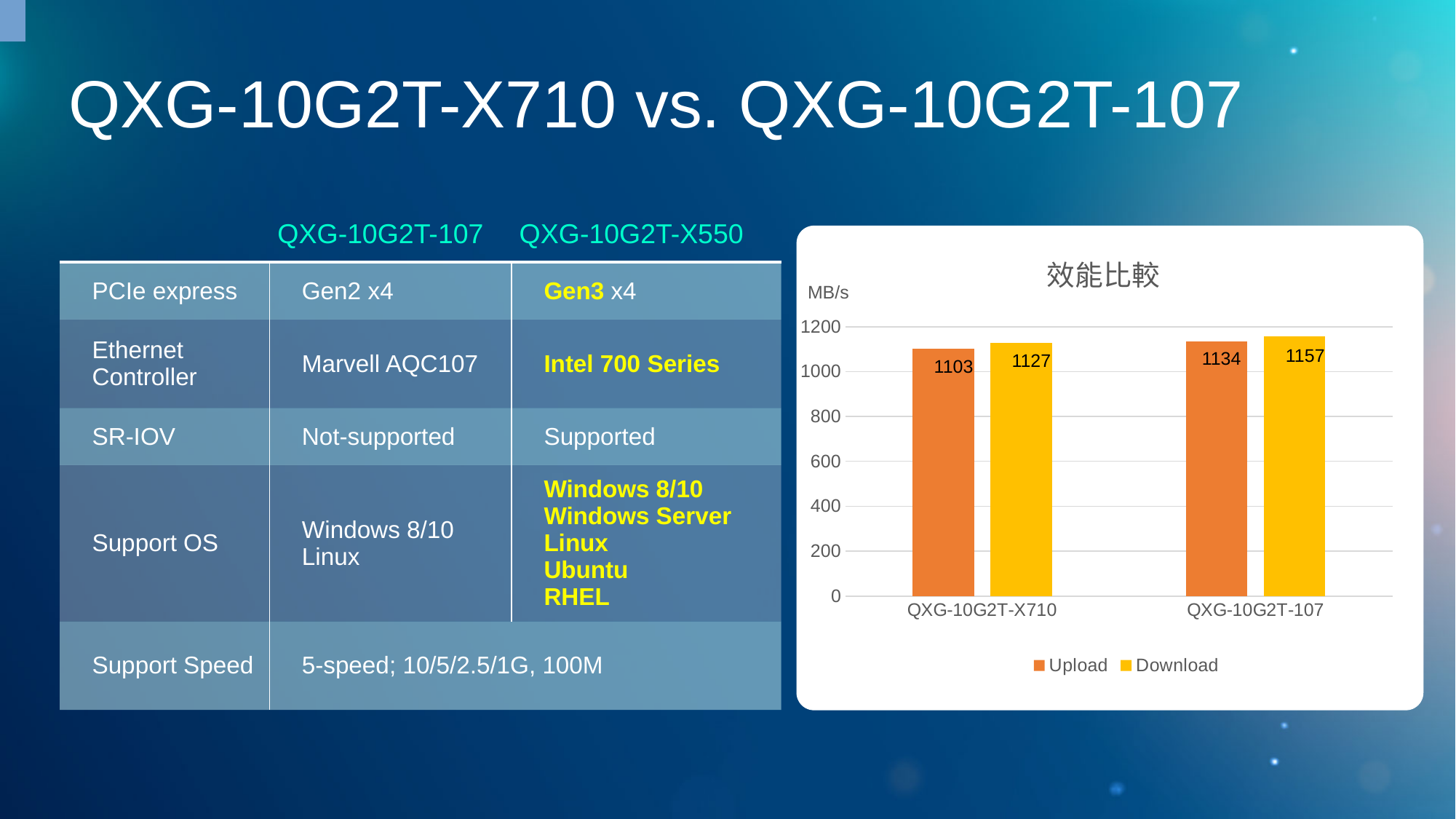
How many series does the chart legend list? 2 What is the difference between the Download and Upload values for QXG-10G2T-107? 23 What type of chart is shown on the slide? Bar chart Which category has the highest Download value? QXG-10G2T-107 What is the Upload value for QXG-10G2T-107? 1134 What is the Download value for QXG-10G2T-X710? 1127 Which is larger: the Download value for QXG-10G2T-X710 or the Upload value for QXG-10G2T-107? Upload value for QXG-10G2T-107 How many categories are shown on the x axis of the chart? 2 Which category has the lowest Upload value? QXG-10G2T-X710 What is the difference between the Upload values of QXG-10G2T-107 and QXG-10G2T-X710? 31 What is the Upload value for QXG-10G2T-X710? 1103 What is the Download value for QXG-10G2T-107? 1157